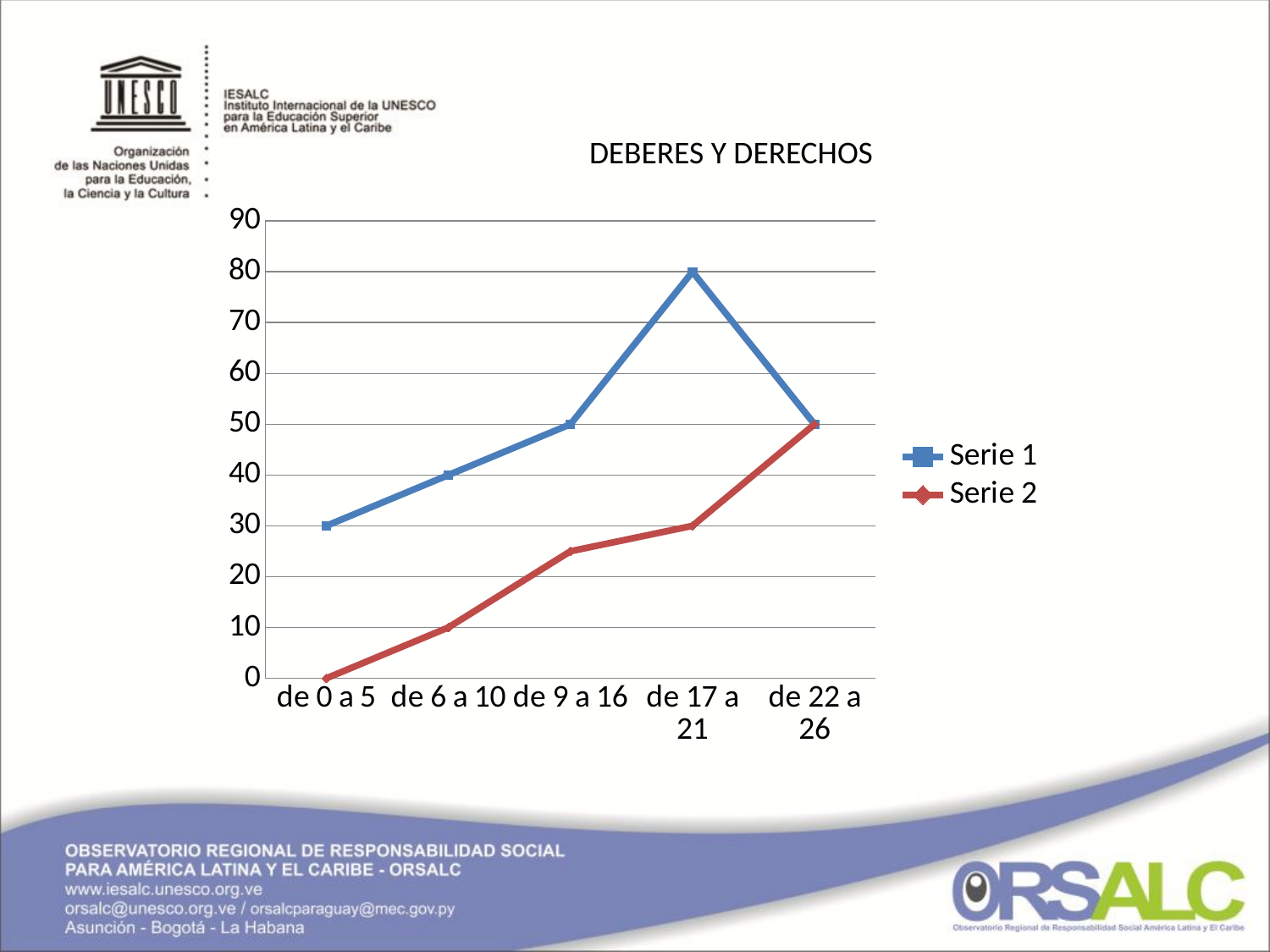
What is the difference between Serie 1 and Serie 2 for the category 'de 17 a 21'? 50 What is the value of Serie 2 for the category 'de 22 a 26'? 50 What kind of chart is shown on the slide? line chart How many categories are shown on the x axis? 5 What is the value of Serie 1 for the category 'de 0 a 5'? 30 What is the value of Serie 1 for the category 'de 17 a 21'? 80 How many series does the legend list? 2 Is the value of Serie 2 for the category 'de 9 a 16' greater or less than 20? greater What is the title of the chart? DEBERES Y DERECHOS For which category does Serie 1 reach its highest value? de 17 a 21 For which category does Serie 2 have its lowest value? de 0 a 5 Which series has the larger value for the category 'de 6 a 10'? Serie 1